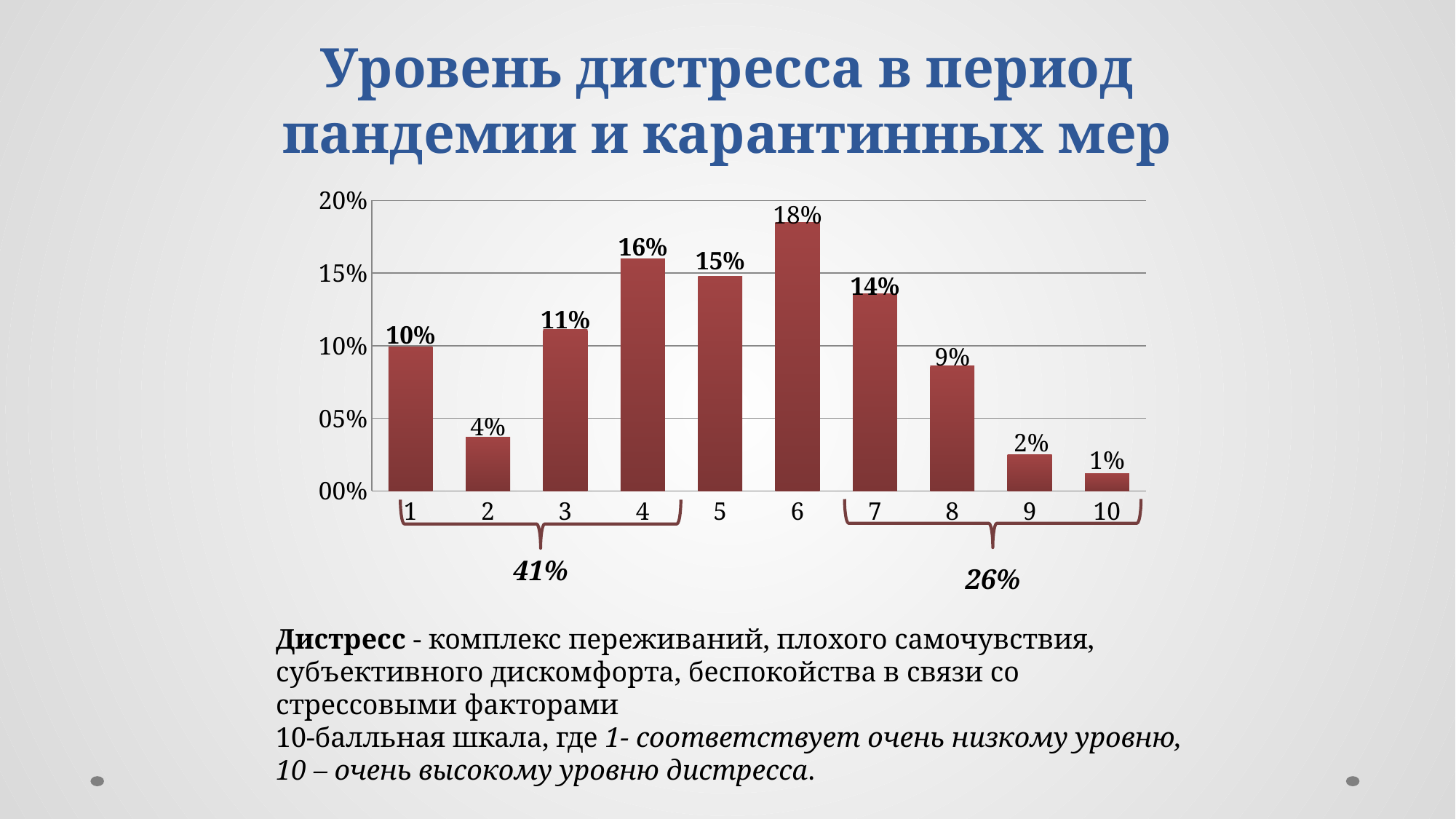
What is the value for category 6? 18% What is the title of the slide? Уровень дистресса в период пандемии и карантинных мер What is the difference between the values for category 6 and category 2? 14% Which category has the highest value? 6 How many categories are shown on the x axis? 10 What kind of chart is shown on the slide? bar chart What is the difference between the values for category 4 and category 8? 7% Is the value for category 5 greater or less than 10%? greater Which is larger, the value for category 3 or the value for category 7? 7 What is the value for category 1? 10% Which category has the lowest value? 10 What is the value for category 9? 2%